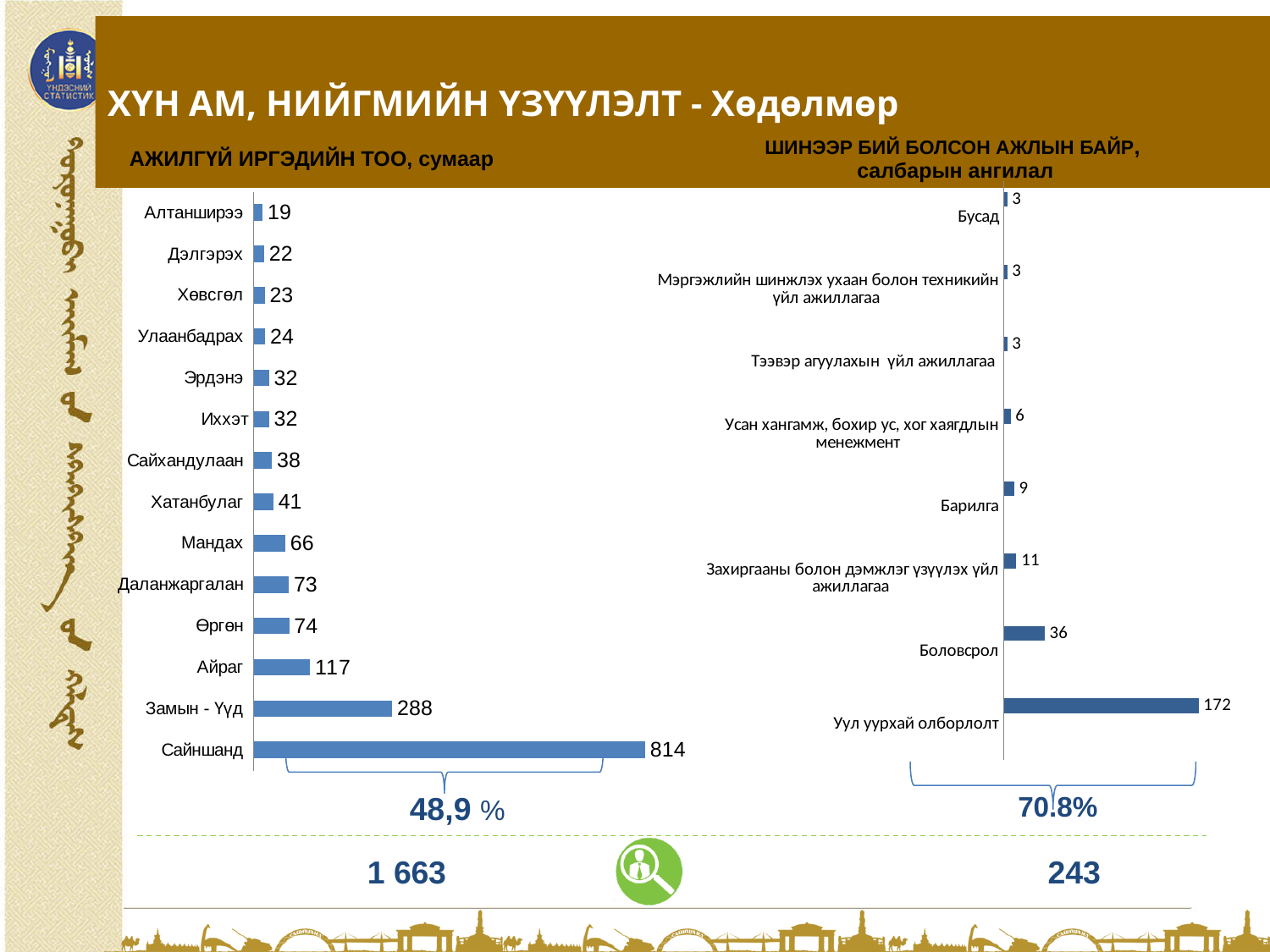
What kind of chart is the chart titled 'АЖИЛГҮЙ ИРГЭДИЙН ТОО, сумаар'? Bar chart In the chart titled 'АЖИЛГҮЙ ИРГЭДИЙН ТОО, сумаар', which is larger, Мандах or Хатанбулаг? Мандах In the chart titled 'АЖИЛГҮЙ ИРГЭДИЙН ТОО, сумаар', what is the value for Сайншанд? 814 In the chart titled 'ШИНЭЭР БИЙ БОЛСОН АЖЛЫН БАЙР, салбарын ангилал', what is the difference between Уул уурхай олборлолт and Боловсрол? 136 How many soums are shown in the chart titled 'АЖИЛГҮЙ ИРГЭДИЙН ТОО, сумаар'? 14 In the chart titled 'АЖИЛГҮЙ ИРГЭДИЙН ТОО, сумаар', what is the difference between Сайншанд and Замын - Үүд? 526 In the chart titled 'ШИНЭЭР БИЙ БОЛСОН АЖЛЫН БАЙР, салбарын ангилал', which sector has the highest value? Уул уурхай олборлолт How many sectors are shown in the chart titled 'ШИНЭЭР БИЙ БОЛСОН АЖЛЫН БАЙР, салбарын ангилал'? 8 In the chart titled 'АЖИЛГҮЙ ИРГЭДИЙН ТОО, сумаар', what is the value for Айраг? 117 In the chart titled 'ШИНЭЭР БИЙ БОЛСОН АЖЛЫН БАЙР, салбарын ангилал', what is the value for Уул уурхай олборлолт? 172 In the chart titled 'ШИНЭЭР БИЙ БОЛСОН АЖЛЫН БАЙР, салбарын ангилал', what is the value for Боловсрол? 36 In the chart titled 'АЖИЛГҮЙ ИРГЭДИЙН ТОО, сумаар', which soum has the lowest value? Алтанширээ